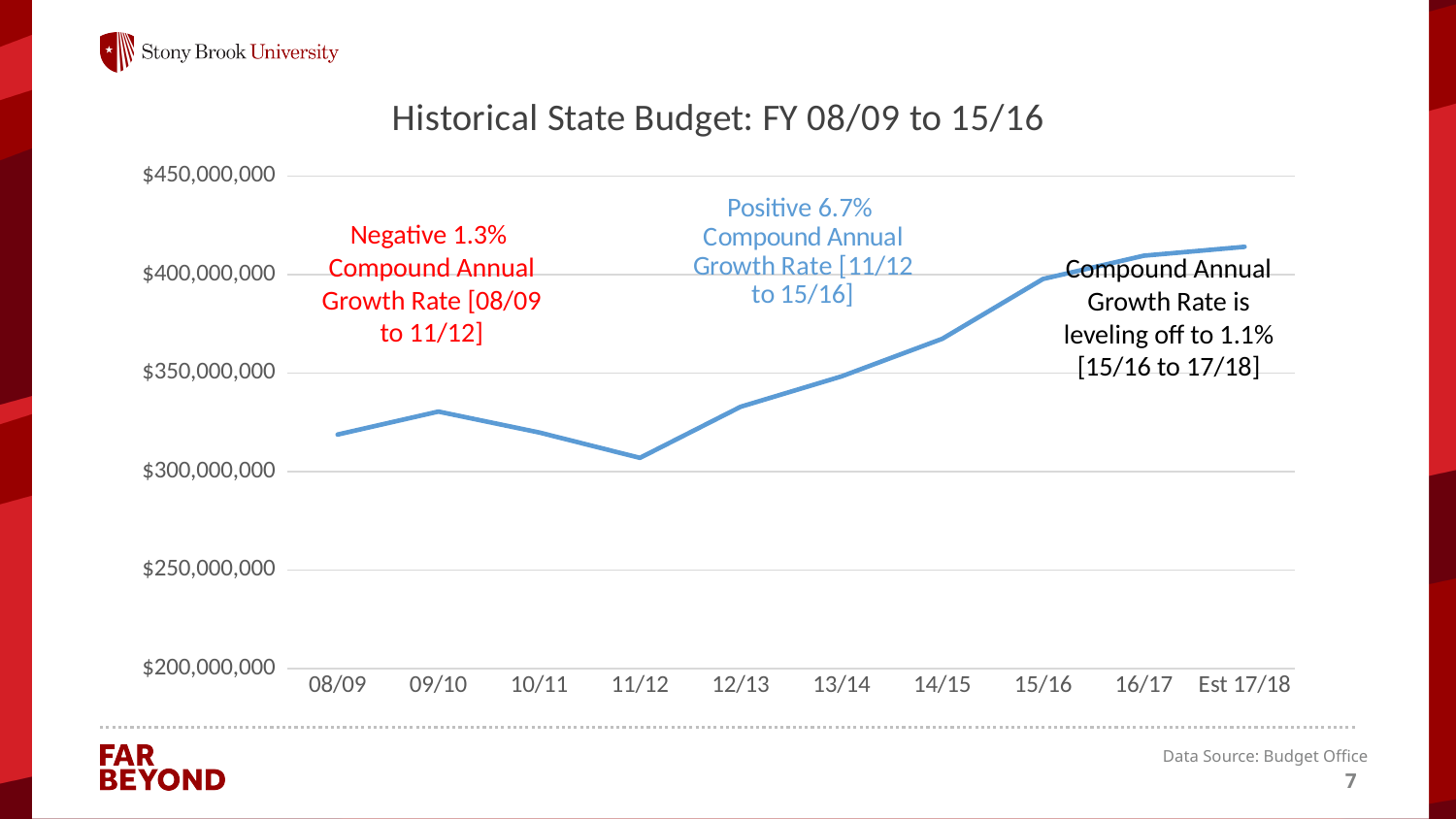
Which is larger, the value for 15/16 or the value for 11/12? 15/16 Is the value for 11/12 greater or less than $350,000,000? less Is the value for 08/09 greater or less than $350,000,000? less How many fiscal years are plotted along the x axis? 10 What kind of chart is shown on the slide? line chart What is the title of the chart? Historical State Budget: FY 08/09 to 15/16 Which fiscal year has the lowest state budget value on the chart? 11/12 Do the values rise or fall from 09/10 to 11/12? fall Do the values rise or fall from 11/12 to 15/16? rise Is the value for 15/16 greater or less than $350,000,000? greater Which is larger, the value for 09/10 or the value for 11/12? 09/10